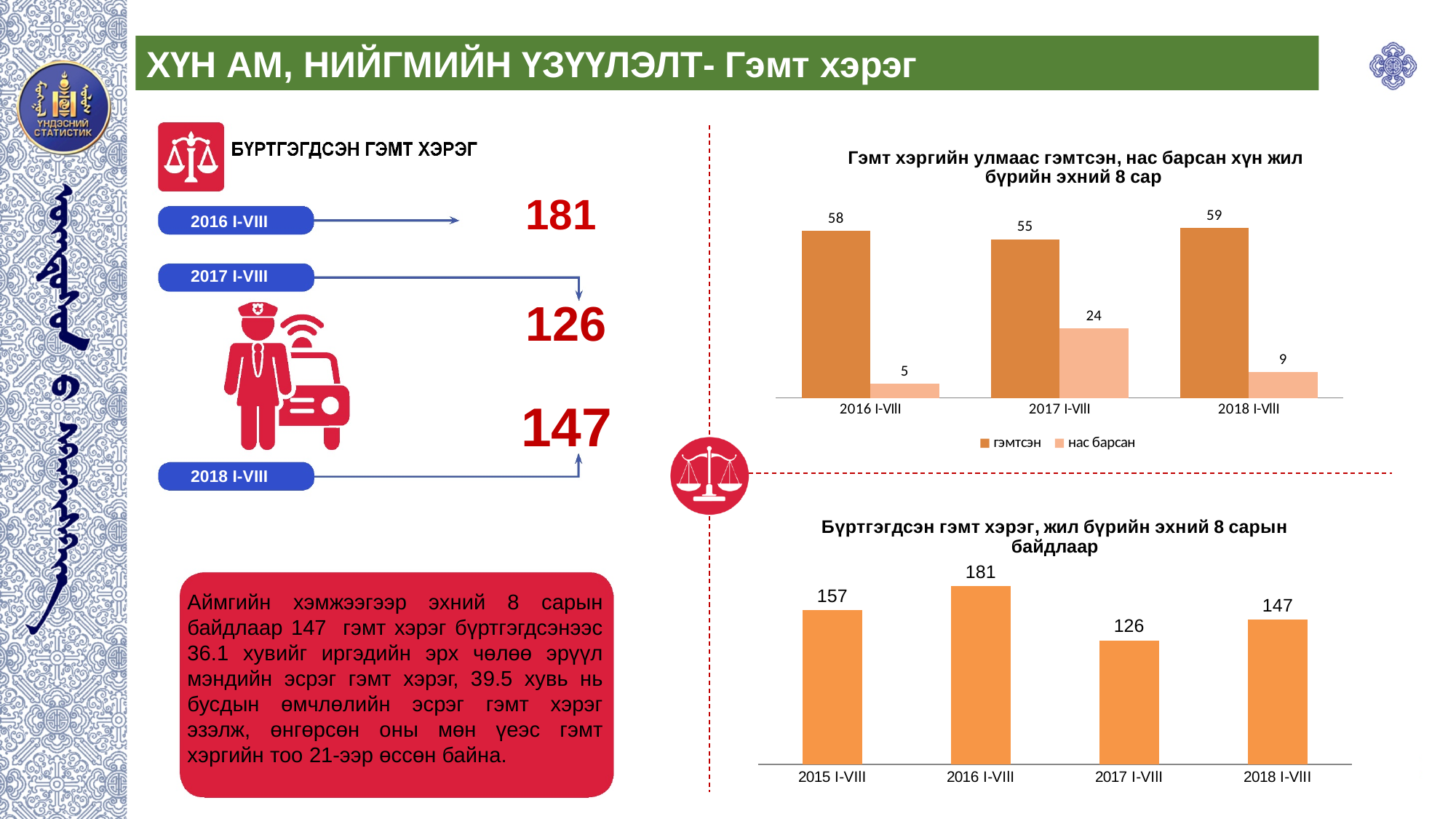
In the top chart (Гэмт хэргийн улмаас гэмтсэн, нас барсан хүн), what are the two legend entries? гэмтсэн, нас барсан In the top chart (Гэмт хэргийн улмаас гэмтсэн, нас барсан хүн), which year has the lowest value for нас барсан? 2016 I-VIII In the bottom chart (Бүртгэгдсэн гэмт хэрэг), what is the value for 2015 I-VIII? 157 In the bottom chart (Бүртгэгдсэн гэмт хэрэг), what is the difference between the values for 2018 I-VIII and 2017 I-VIII? 21 In the top chart (Гэмт хэргийн улмаас гэмтсэн, нас барсан хүн), which year has the highest value for гэмтсэн? 2018 I-VIII In the bottom chart (Бүртгэгдсэн гэмт хэрэг), which year has the lowest value? 2017 I-VIII In the bottom chart (Бүртгэгдсэн гэмт хэрэг), which year has the highest value? 2016 I-VIII In the top chart (Гэмт хэргийн улмаас гэмтсэн, нас барсан хүн), how many series does the legend list? 2 In the top chart (Гэмт хэргийн улмаас гэмтсэн, нас барсан хүн), what is the difference between гэмтсэн and нас барсан in 2018 I-VIII? 50 In the bottom chart (Бүртгэгдсэн гэмт хэрэг), how many categories are shown on the x axis? 4 In the top chart (Гэмт хэргийн улмаас гэмтсэн, нас барсан хүн), what is the value for гэмтсэн in 2017 I-VIII? 55 In the top chart (Гэмт хэргийн улмаас гэмтсэн, нас барсан хүн), what is the value for нас барсан in 2017 I-VIII? 24